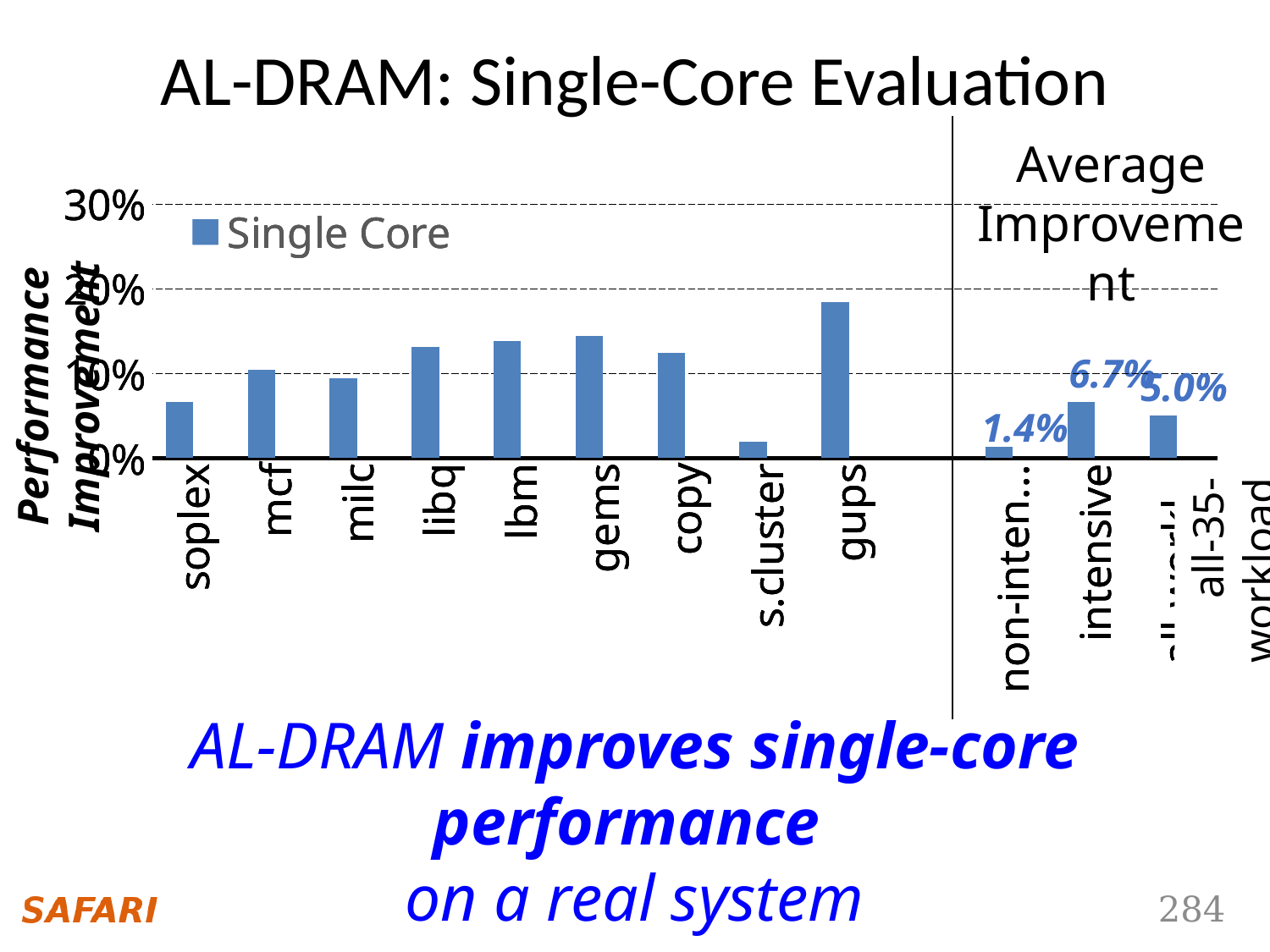
What kind of chart is this? bar chart Is the value for gups greater or less than 20%? less What is the value for the intensive category? 6.7% What is the difference between the intensive value and the non-intensive value? 5.3% How many series does the legend list? 1 Is the value for soplex greater or less than 10%? less How many categories are shown on the x axis? 12 What is the value for the all-35-workload category? 5.0% Among the nine individual benchmarks to the left of the divider, which has the lowest bar? s.cluster Which is larger, the value for gups or the value for copy? gups Which category has the highest bar? gups What is the value for the non-intensive category? 1.4%